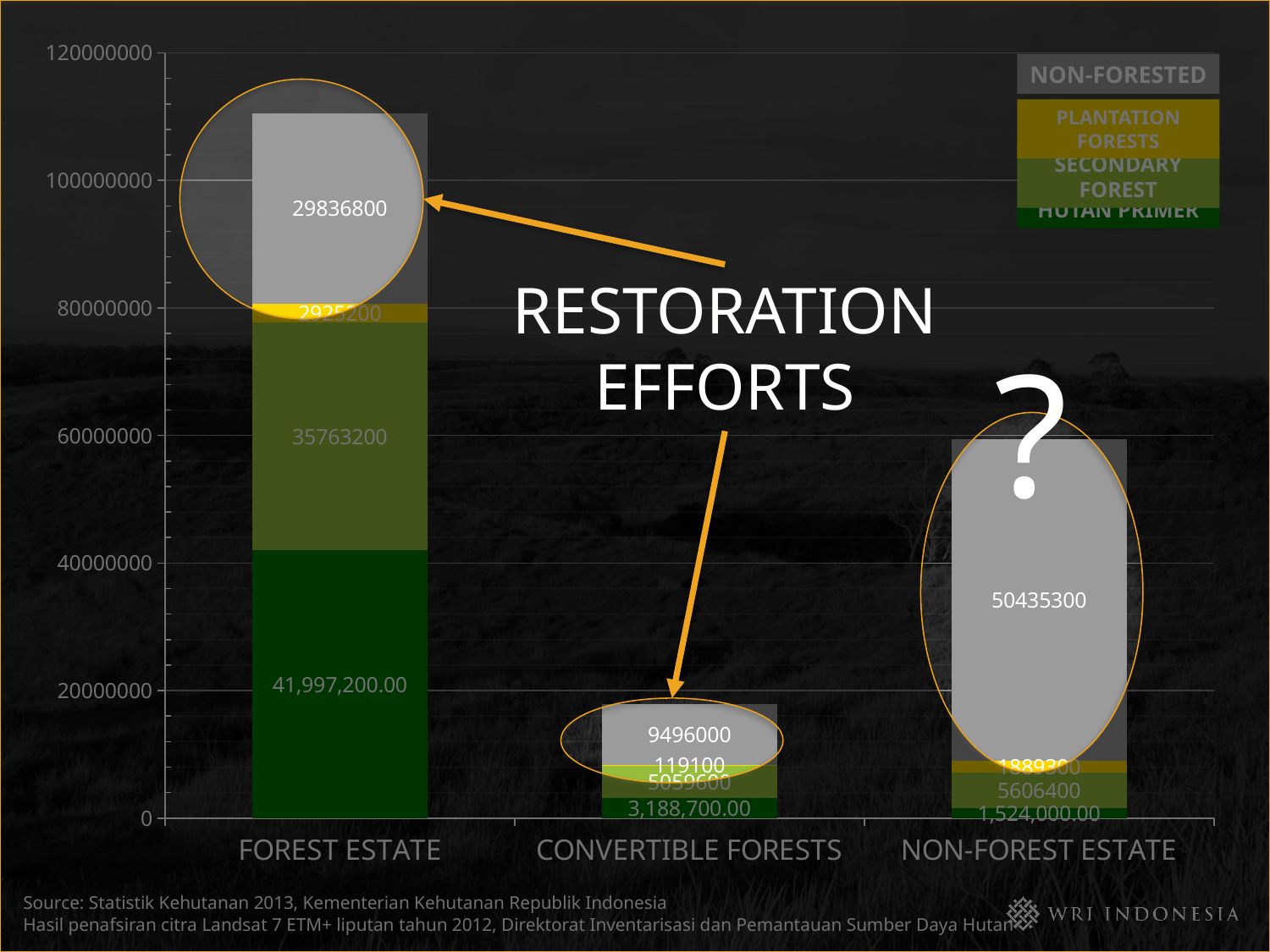
What is the SECONDARY FOREST value for NON-FOREST ESTATE? 5606400 How many categories are shown on the x axis? 3 What is the NON-FORESTED value for FOREST ESTATE? 29836800 How many series does the legend list? 4 Is the total stacked value for FOREST ESTATE greater or less than 100000000? greater What is the HUTAN PRIMER value for FOREST ESTATE? 41,997,200.00 What is the NON-FORESTED value for CONVERTIBLE FORESTS? 9496000 Which is larger, the SECONDARY FOREST value for FOREST ESTATE or for NON-FOREST ESTATE? FOREST ESTATE Which category has the lowest HUTAN PRIMER value? NON-FOREST ESTATE What is the NON-FORESTED value for NON-FOREST ESTATE? 50435300 Which category has the highest NON-FORESTED value? NON-FOREST ESTATE What is the difference between the NON-FORESTED values for NON-FOREST ESTATE and FOREST ESTATE? 20598500